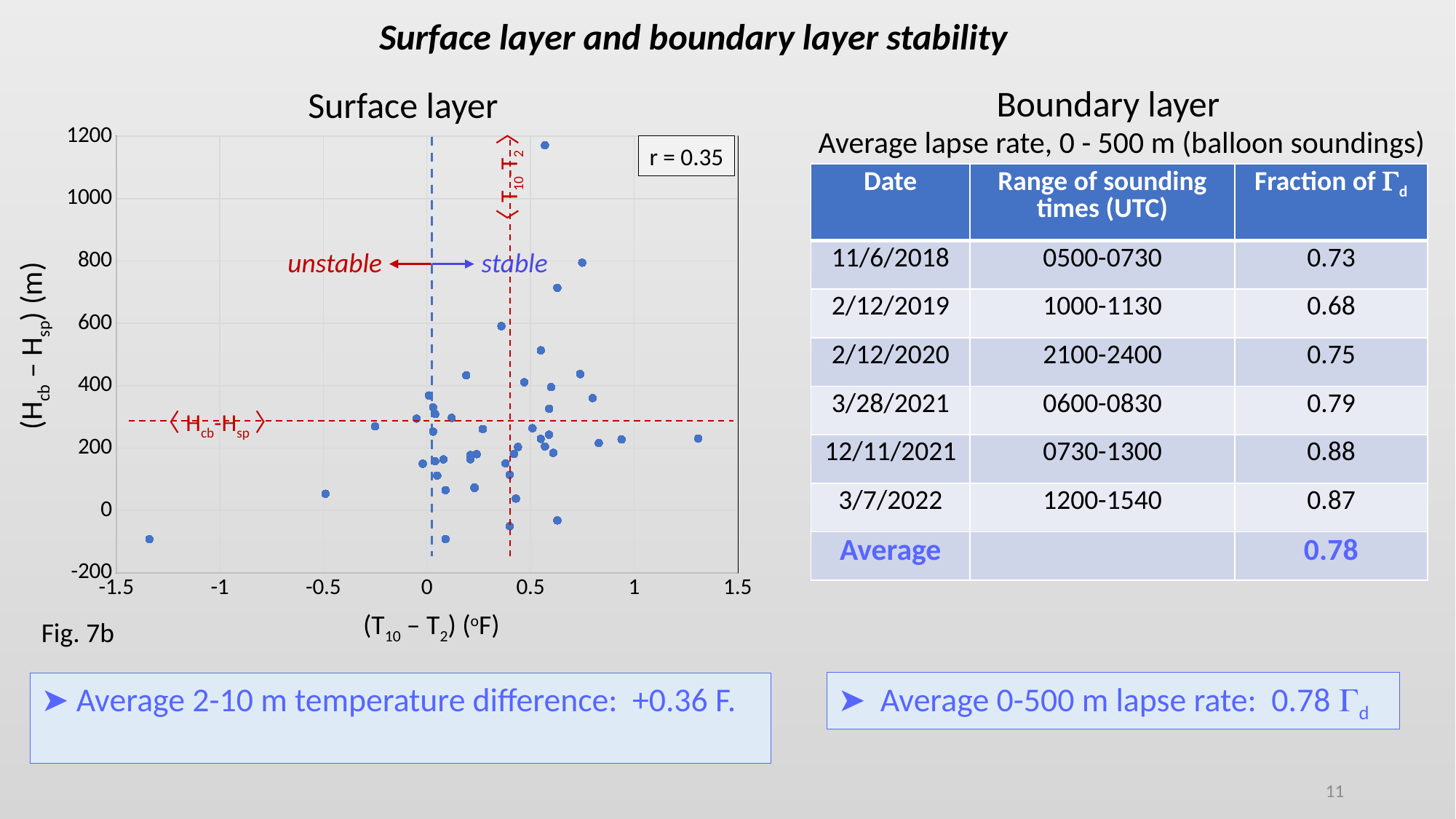
On the Surface layer chart, which has the larger y value: the point near x = 1.3 or the point near x = -1.35? the point near x = 1.3 On the Surface layer chart, is the y value of the point near x = 0.75 and y ≈ 800 greater or less than 600? greater What is the maximum value shown on the y axis of the Surface layer chart? 1200 What is the minimum value shown on the x axis of the Surface layer chart? -1.5 On the Surface layer chart, does the highest point lie on the "stable" or the "unstable" side of the dashed vertical line at x = 0? stable On the Surface layer chart, is the y value of the highest point greater or less than 1000? greater What correlation coefficient is printed on the Surface layer chart? r = 0.35 What is the label of the x axis on the Surface layer chart? (T10 – T2) (°F) On the Surface layer chart, is the y value of the point near x = -0.5 greater or less than 200? less What is the label of the y axis on the Surface layer chart? (Hcb – Hsp) (m) What kind of chart is shown under the title "Surface layer"? scatter plot